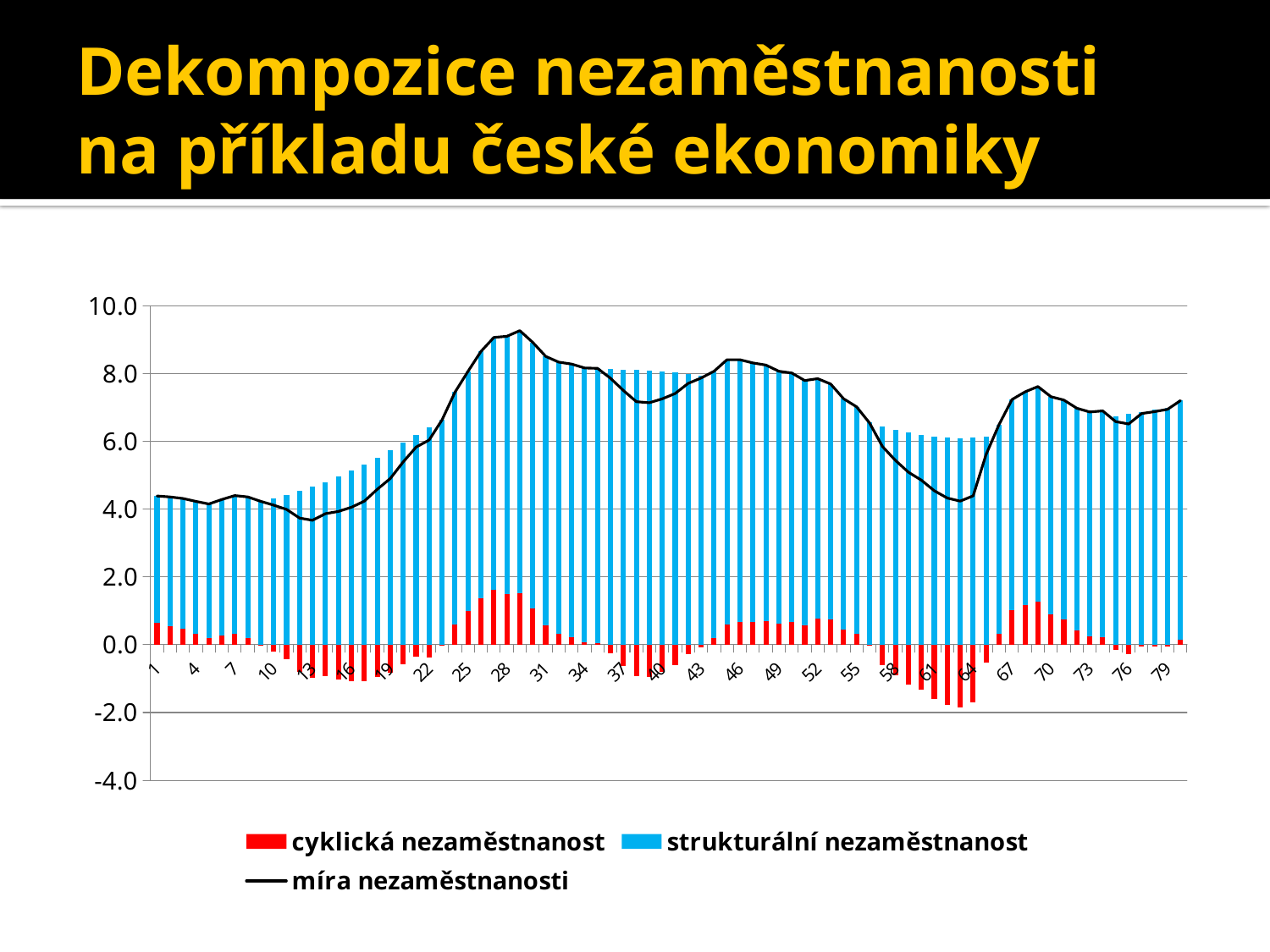
Is the value of míra nezaměstnanosti at period 13 greater or less than 4.0? less How many series does the legend list? 3 Is the value of cyklická nezaměstnanost at period 61 greater or less than -1.0? less Which series is drawn in red? cyklická nezaměstnanost What kind of chart is shown on the slide? A stacked bar chart combined with a line Is míra nezaměstnanosti at period 28 higher or lower than at period 64? higher Is the value of míra nezaměstnanosti at period 58 greater or less than 6.0? less Which series is drawn as a black line? míra nezaměstnanosti Does míra nezaměstnanosti rise or fall between period 1 and period 28? rise